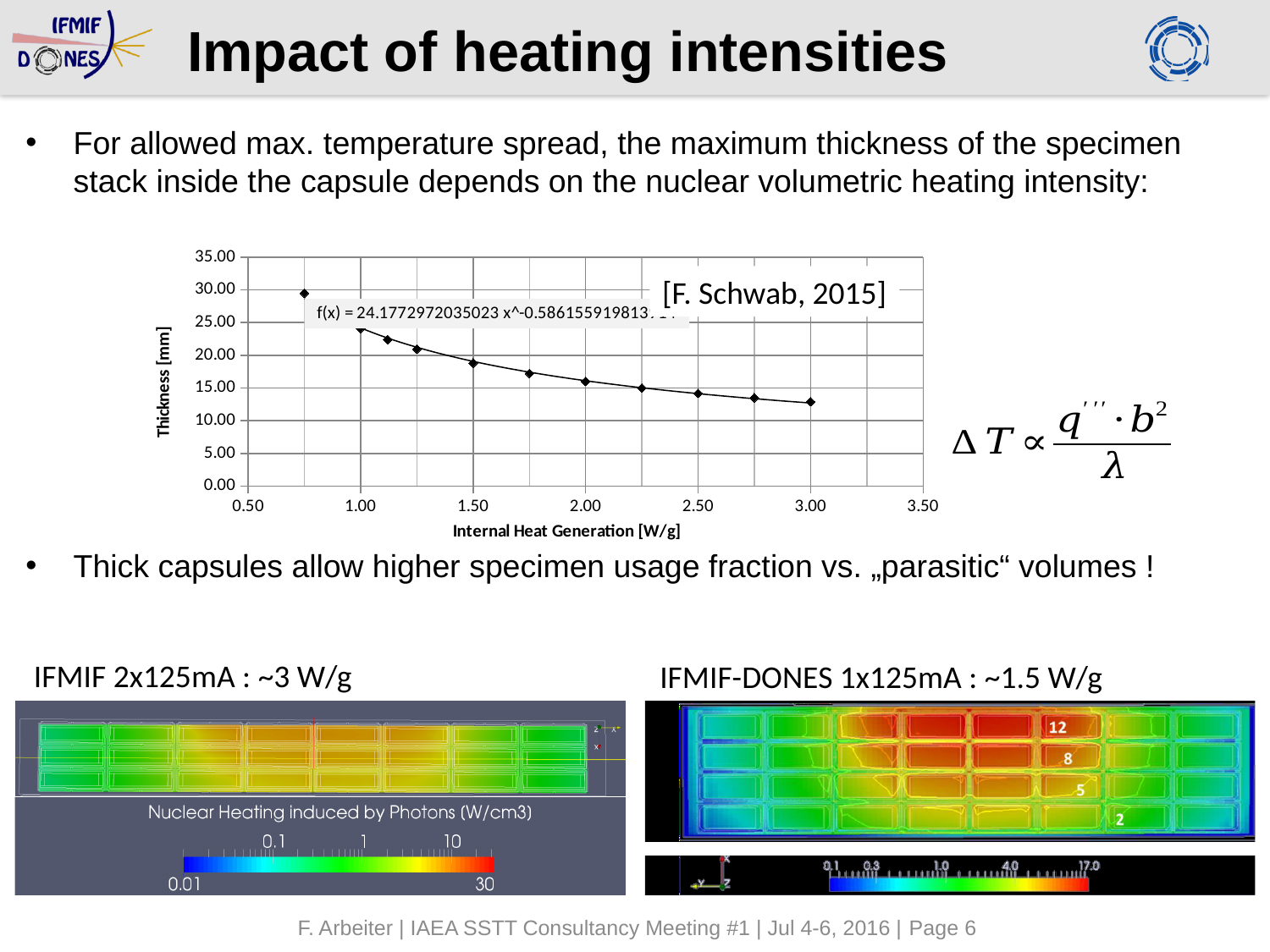
At which internal heat generation value is the plotted thickness lowest? 3.00 W/g Which plotted point has the highest thickness: the one at 1.00 W/g or the one at 2.00 W/g? 1.00 W/g As internal heat generation increases along the x axis, does the thickness rise or fall? Fall What kind of chart is shown on the slide? Scatter chart with a fitted trend line What is the label of the vertical axis of the chart? Thickness [mm] Is the thickness at an internal heat generation of 1.00 W/g greater or less than 20.00 mm? greater How many data points are plotted in the chart? 11 What is the label of the horizontal axis of the chart? Internal Heat Generation [W/g] What is the maximum value shown on the vertical axis of the chart? 35.00 Is the thickness at the lowest plotted heat generation (about 0.75 W/g) greater or less than 25.00 mm? greater Is the thickness at an internal heat generation of 3.00 W/g greater or less than 15.00 mm? less